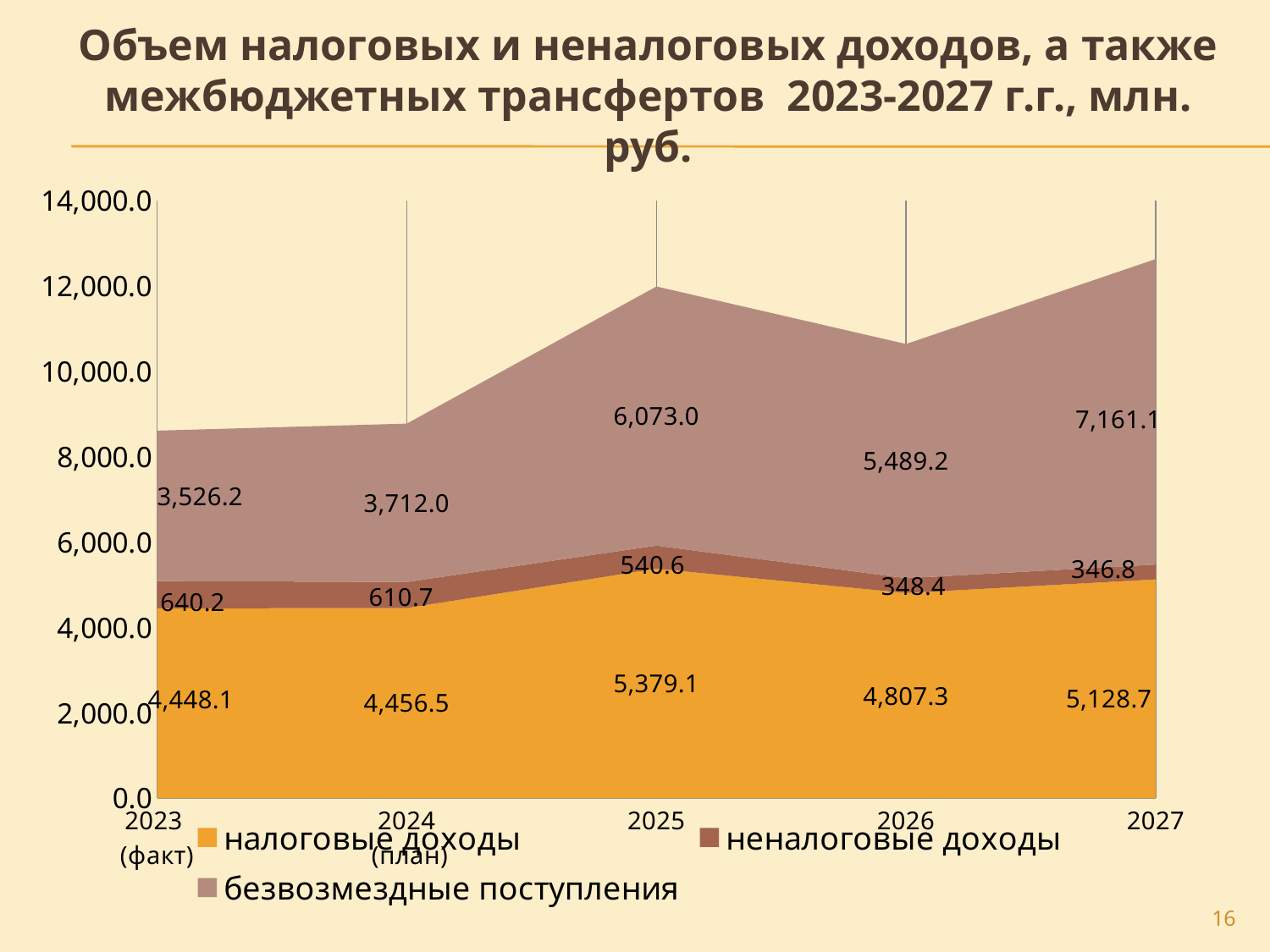
How many years are plotted along the x axis? 5 Do неналоговые доходы rise or fall from 2023 to 2027? Fall What is the value of неналоговые доходы for 2027? 346.8 What is the value of налоговые доходы for 2025? 5,379.1 Which is larger: налоговые доходы in 2026 or in 2027? 2027 In which year are неналоговые доходы lowest? 2027 What is the total of the three series for 2027? 12,636.6 How many series does the legend list? 3 What kind of chart is shown on the slide? Stacked area chart In which year are безвозмездные поступления highest? 2027 What is the difference between безвозмездные поступления in 2027 and in 2023 (факт)? 3,634.9 What is the value of безвозмездные поступления for 2024 (план)? 3,712.0